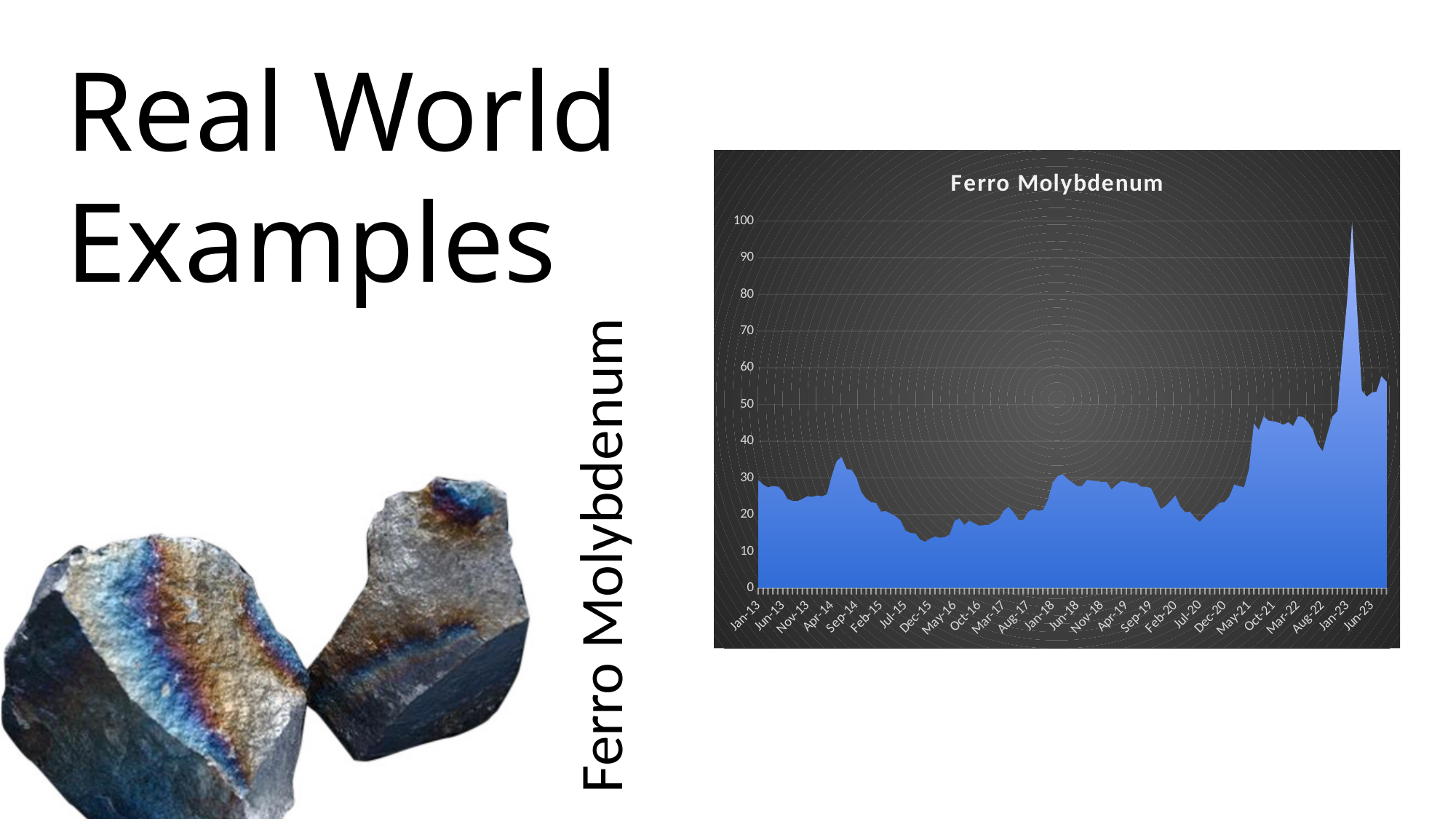
Around which x-axis label does the Ferro Molybdenum series reach its highest value? Jan-23 Is the value at Dec-15 greater or less than 20? less How many date labels are shown along the x axis of the chart? 26 What is the title of the chart? Ferro Molybdenum What kind of chart is shown on the slide? Area chart Is the value at Jun-23 greater or less than 50? greater Around which x-axis label does the Ferro Molybdenum series reach its lowest value? Dec-15 Which is larger, the value at Jan-23 or the value at Jan-13? Jan-23 Is the value at Jan-23 greater or less than 90? less Overall, does the Ferro Molybdenum value rise or fall from Jan-13 to Jun-23? rise What is the highest value shown on the chart's vertical axis? 100